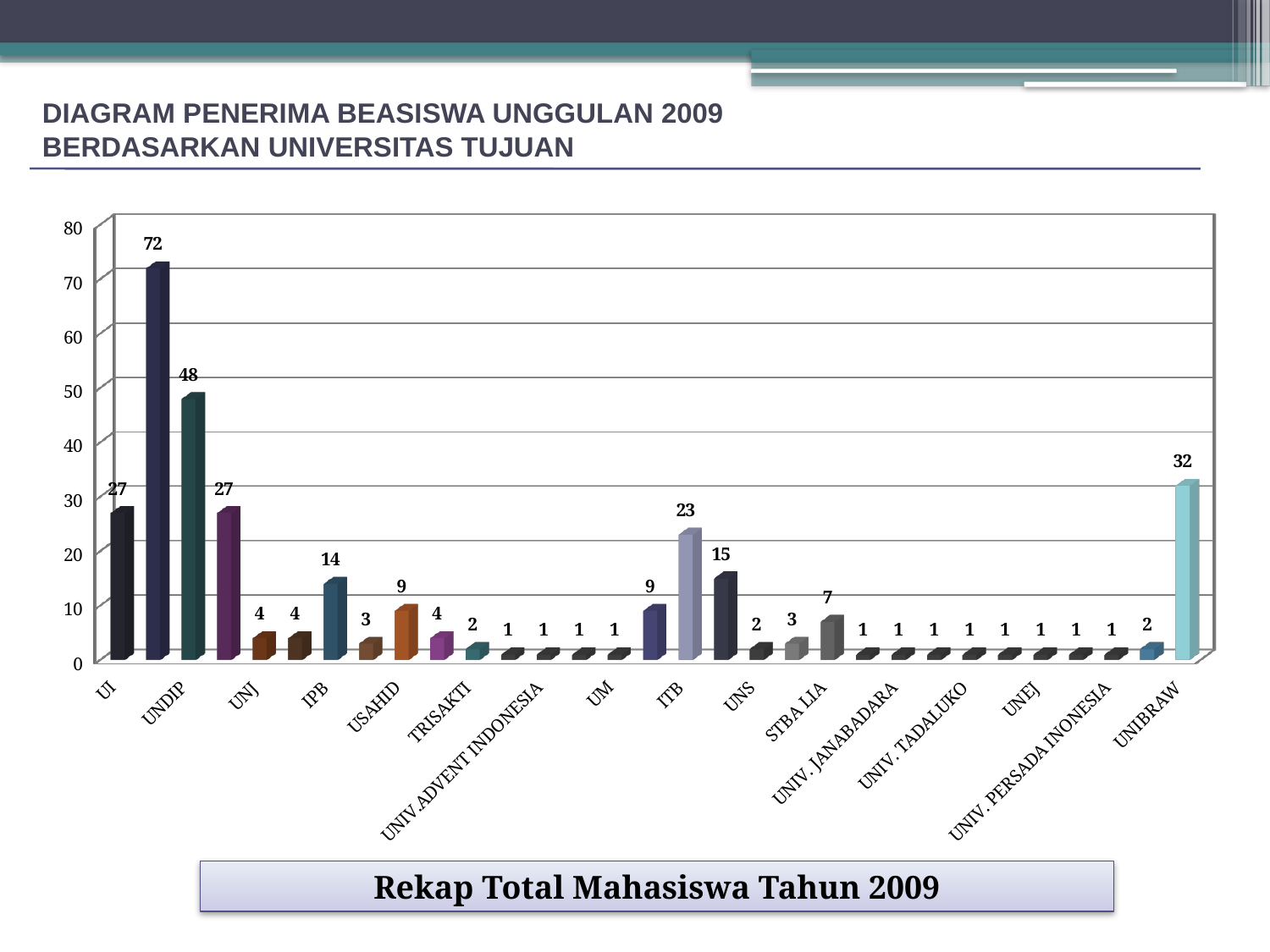
Is the value for UNIBRAW greater or less than 30? greater What kind of chart is shown on the slide? bar chart Which is larger, the value for ITB or the value for UNIBRAW? UNIBRAW What is the difference between the values for UNIBRAW and UI? 5 What is the caption shown in the box below the chart? Rekap Total Mahasiswa Tahun 2009 What is the highest value shown on the chart? 72 What is the value for UI? 27 What is the value for IPB? 14 How many bars are plotted on the chart? 31 What is the value for UNIBRAW? 32 What is the value for STBA LIA? 7 What is the value for ITB? 23